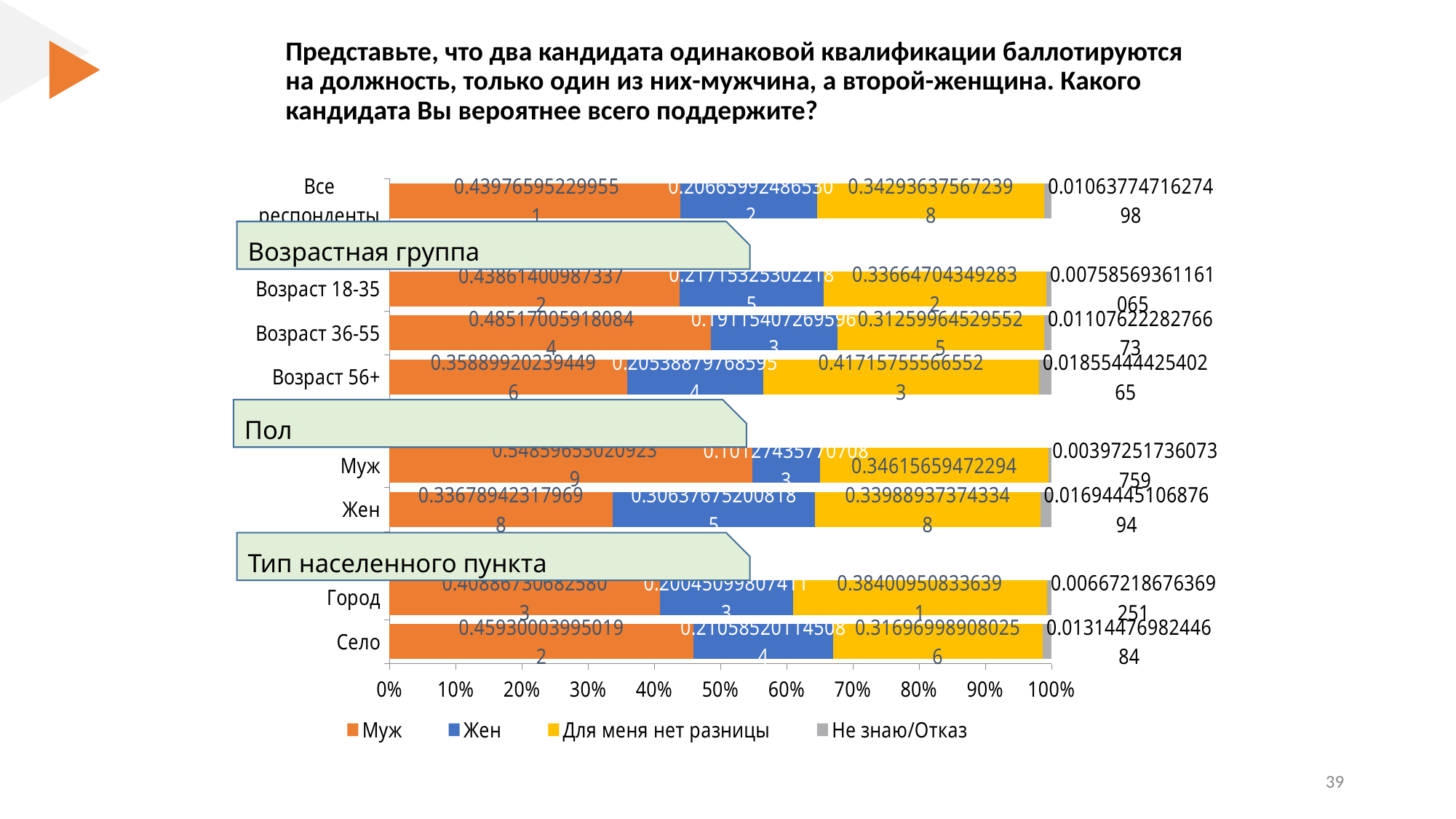
What kind of chart is shown on the slide? Stacked bar chart Which has a larger 'Муж' share, Город or Село? Село What colour represents the 'Для меня нет разницы' series in the legend? Yellow Which category has the lowest share for the 'Жен' series? Муж Is the 'Муж' share for the 'Муж' category greater or less than 50%? greater Which has a larger 'Жен' share, Возраст 18-35 or Возраст 36-55? Возраст 18-35 How many respondent categories are plotted on the chart? 8 Which category has the highest share for the 'Жен' series? Жен Is the 'Муж' share for 'Возраст 56+' greater or less than 40%? less Which category has the highest share for 'Для меня нет разницы'? Возраст 56+ How many series does the legend list? 4 Which category has the highest share for the 'Муж' series? Муж